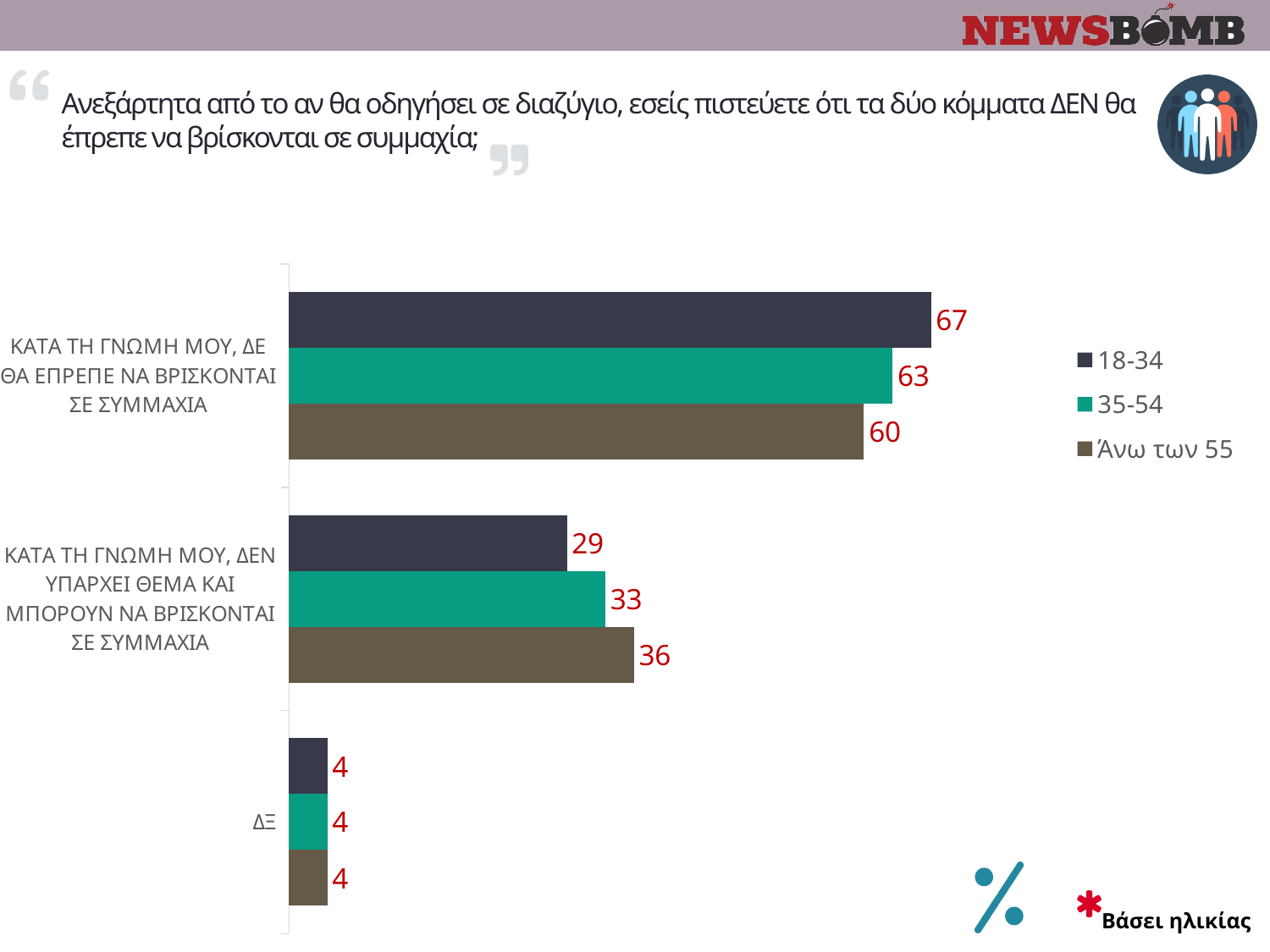
Which is larger: the 35-54 value for "ΚΑΤΑ ΤΗ ΓΝΩΜΗ ΜΟΥ, ΔΕ ΘΑ ΕΠΡΕΠΕ ΝΑ ΒΡΙΣΚΟΝΤΑΙ ΣΕ ΣΥΜΜΑΧΙΑ" or the 35-54 value for "ΚΑΤΑ ΤΗ ΓΝΩΜΗ ΜΟΥ, ΔΕΝ ΥΠΑΡΧΕΙ ΘΕΜΑ ΚΑΙ ΜΠΟΡΟΥΝ ΝΑ ΒΡΙΣΚΟΝΤΑΙ ΣΕ ΣΥΜΜΑΧΙΑ"? ΚΑΤΑ ΤΗ ΓΝΩΜΗ ΜΟΥ, ΔΕ ΘΑ ΕΠΡΕΠΕ ΝΑ ΒΡΙΣΚΟΝΤΑΙ ΣΕ ΣΥΜΜΑΧΙΑ What is the value for the 18-34 series in the category "ΚΑΤΑ ΤΗ ΓΝΩΜΗ ΜΟΥ, ΔΕ ΘΑ ΕΠΡΕΠΕ ΝΑ ΒΡΙΣΚΟΝΤΑΙ ΣΕ ΣΥΜΜΑΧΙΑ"? 67 How many categories are shown on the chart? 3 How many series does the legend list? 3 What is the difference between the 18-34 and Άνω των 55 values in the category "ΚΑΤΑ ΤΗ ΓΝΩΜΗ ΜΟΥ, ΔΕ ΘΑ ΕΠΡΕΠΕ ΝΑ ΒΡΙΣΚΟΝΤΑΙ ΣΕ ΣΥΜΜΑΧΙΑ"? 7 What is the value for the 35-54 series in the ΔΞ category? 4 Which age group has the highest value in the category "ΚΑΤΑ ΤΗ ΓΝΩΜΗ ΜΟΥ, ΔΕ ΘΑ ΕΠΡΕΠΕ ΝΑ ΒΡΙΣΚΟΝΤΑΙ ΣΕ ΣΥΜΜΑΧΙΑ"? 18-34 What is the value for the Άνω των 55 series in the category "ΚΑΤΑ ΤΗ ΓΝΩΜΗ ΜΟΥ, ΔΕΝ ΥΠΑΡΧΕΙ ΘΕΜΑ ΚΑΙ ΜΠΟΡΟΥΝ ΝΑ ΒΡΙΣΚΟΝΤΑΙ ΣΕ ΣΥΜΜΑΧΙΑ"? 36 What kind of chart is shown on the slide? Bar chart Which age group has the lowest value in the category "ΚΑΤΑ ΤΗ ΓΝΩΜΗ ΜΟΥ, ΔΕΝ ΥΠΑΡΧΕΙ ΘΕΜΑ ΚΑΙ ΜΠΟΡΟΥΝ ΝΑ ΒΡΙΣΚΟΝΤΑΙ ΣΕ ΣΥΜΜΑΧΙΑ"? 18-34 Which series is shown in green in the legend? 35-54 What is the difference between the Άνω των 55 and 18-34 values in the category "ΚΑΤΑ ΤΗ ΓΝΩΜΗ ΜΟΥ, ΔΕΝ ΥΠΑΡΧΕΙ ΘΕΜΑ ΚΑΙ ΜΠΟΡΟΥΝ ΝΑ ΒΡΙΣΚΟΝΤΑΙ ΣΕ ΣΥΜΜΑΧΙΑ"? 7